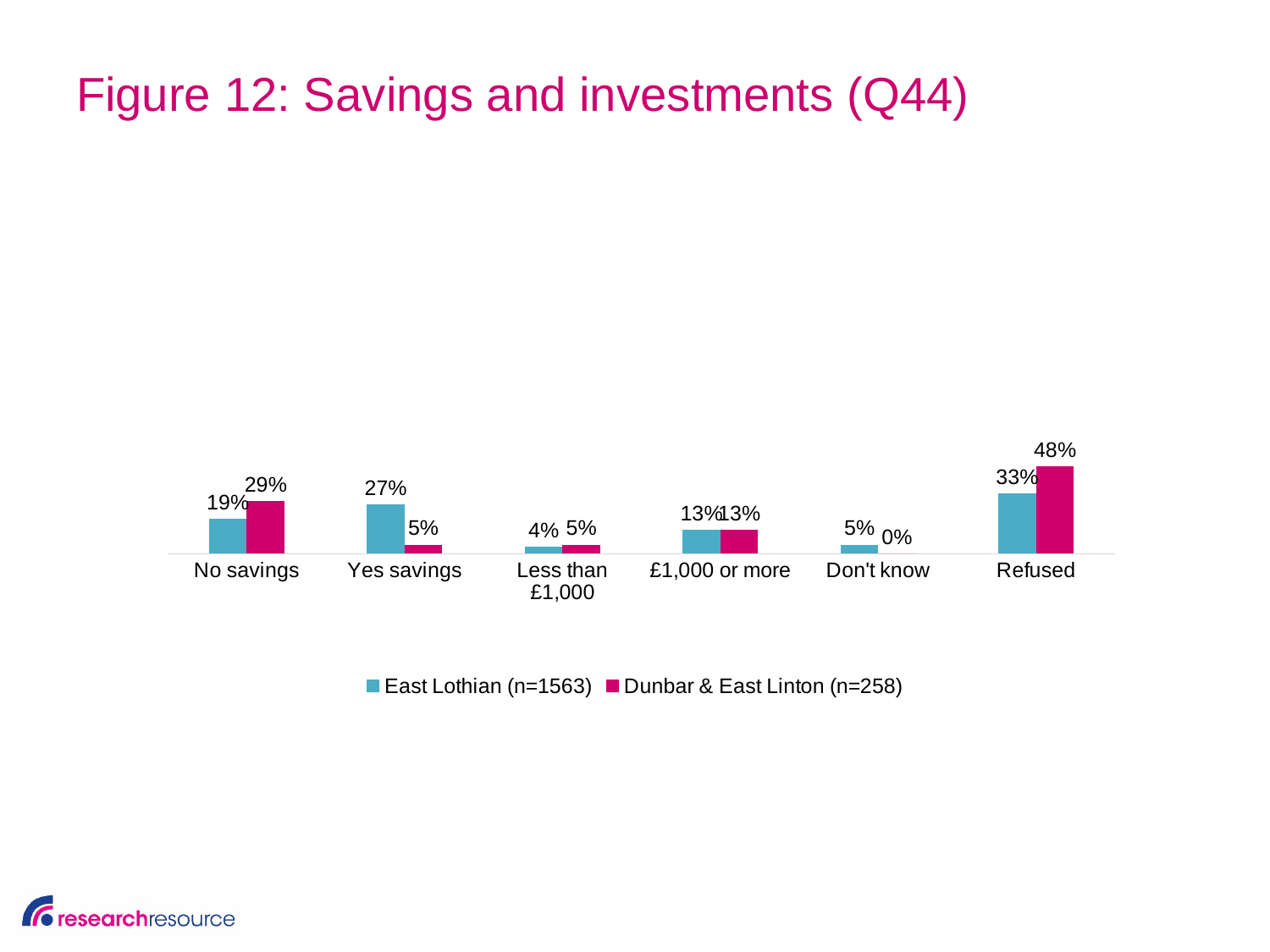
What is the title of the chart? Figure 12: Savings and investments (Q44) What kind of chart is shown on the slide? Bar chart Which category has the lowest value for Dunbar & East Linton? Don't know What is the value for East Lothian in the 'Don't know' category? 5% Which series has the larger value in the 'No savings' category? Dunbar & East Linton (n=258) How many categories are shown on the x axis? 6 What is the value for Dunbar & East Linton in the 'Yes savings' category? 5% What is the difference between Dunbar & East Linton and East Lothian in the 'Yes savings' category? 22% How many series does the legend list? 2 What is the value for East Lothian in the 'No savings' category? 19% What is the value for Dunbar & East Linton in the 'Refused' category? 48% Which category has the highest value for East Lothian? Refused